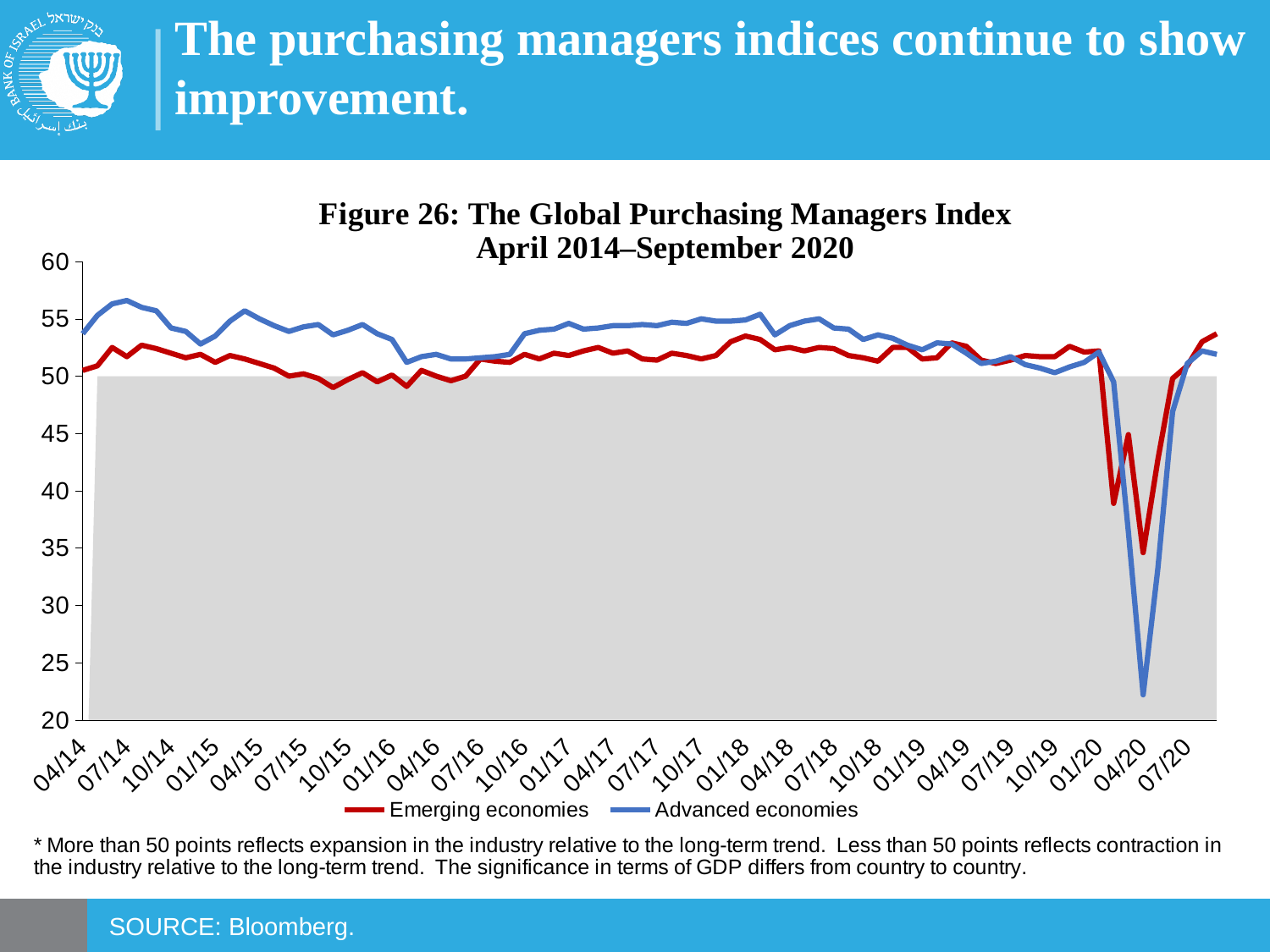
At 04/20, which series has the higher value, Emerging economies or Advanced economies? Emerging economies Between 04/20 and 07/20, do the values for Advanced economies rise or fall? rise What is the title of the chart? Figure 26: The Global Purchasing Managers Index April 2014–September 2020 Is the value for Advanced economies at 07/14 greater or less than 55? greater Is the value for Advanced economies at 04/20 greater or less than 25? less Is the value for Advanced economies at 04/14 greater or less than 50? greater What kind of chart is Figure 26? line chart Which colour represents Emerging economies in the chart? red Which series falls to the lowest value in the chart? Advanced economies How many series does the legend list? 2